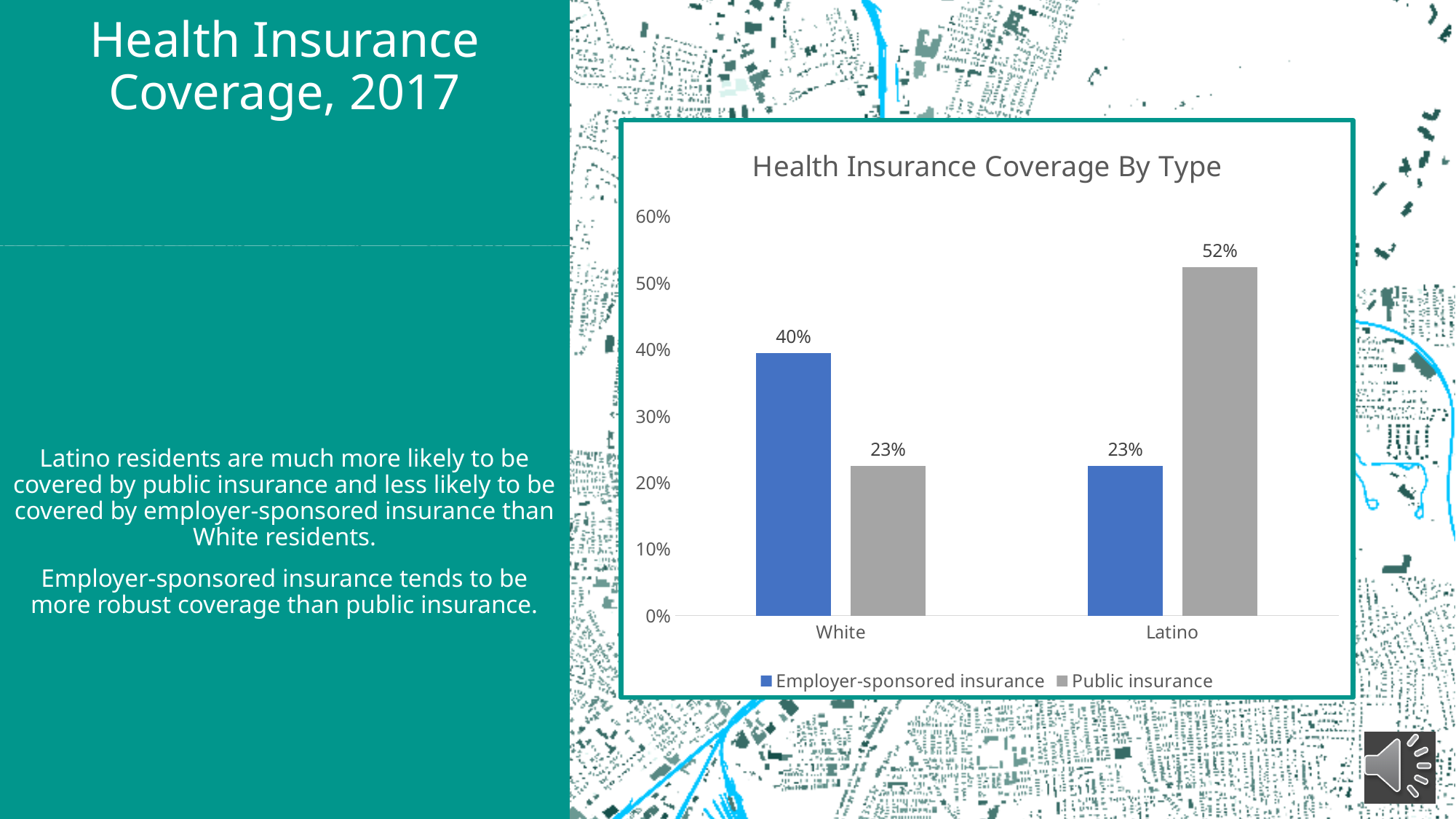
How many series does the legend list? 2 What is the value for Public insurance for White residents? 23% What is the value for Public insurance for Latino residents? 52% Which is larger for Latino residents: Employer-sponsored insurance or Public insurance? Public insurance Which category has the highest Public insurance value? Latino What is the value for Employer-sponsored insurance for White residents? 40% What is the difference between the Public insurance values for Latino and White residents? 29% How many categories are shown on the x axis? 2 Which category has the lowest Employer-sponsored insurance value? Latino What kind of chart is shown on the slide? Bar chart What is the difference between Employer-sponsored insurance and Public insurance for White residents? 17% What is the value for Employer-sponsored insurance for Latino residents? 23%